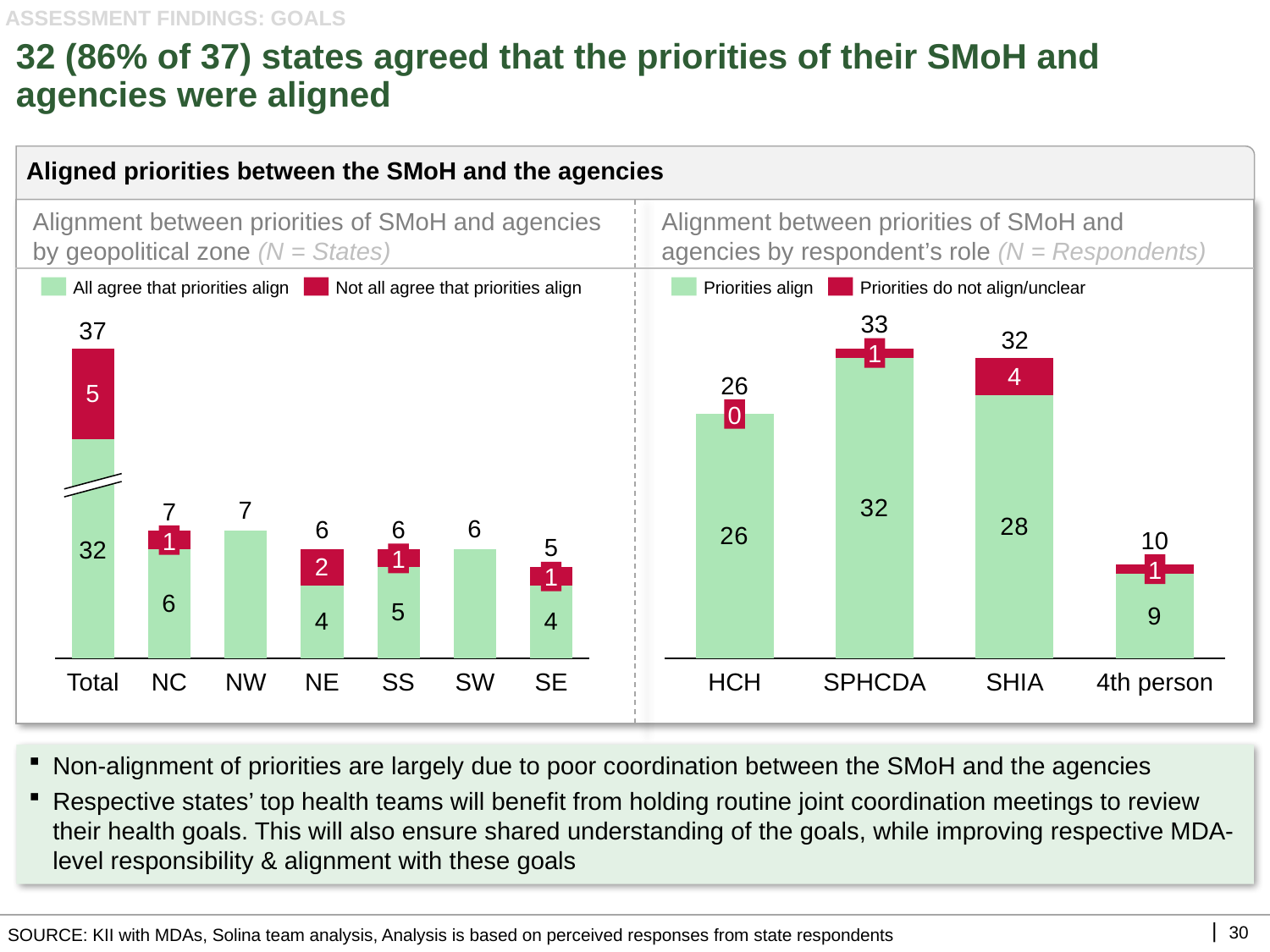
In the right chart (by respondent's role), which role has the highest total value? SPHCDA In the right chart (by respondent's role), is the total for HCH larger or the total for 4th person? HCH In the right chart (by respondent's role), what is the difference between the total for SPHCDA and the total for SHIA? 1 In the right chart (by respondent's role), which role has the largest 'Priorities do not align/unclear' value? SHIA In the left chart (by geopolitical zone), how many series does the legend list? 2 In the left chart (by geopolitical zone), what is the total value shown above the Total bar? 37 In the right chart (by respondent's role), what is the 'Priorities align' value for SHIA? 28 In the left chart (by geopolitical zone), how many states in the NE zone are in the 'Not all agree that priorities align' segment? 2 In the left chart (by geopolitical zone), which zone (excluding Total) has the lowest total value? SE What type of chart is used in the right chart (by respondent's role)? Stacked bar chart In the left chart (by geopolitical zone), how many zone categories are shown on the x axis, including Total? 7 In the left chart (by geopolitical zone), what is the difference between the 'All agree' value for NC and the 'All agree' value for NE? 2